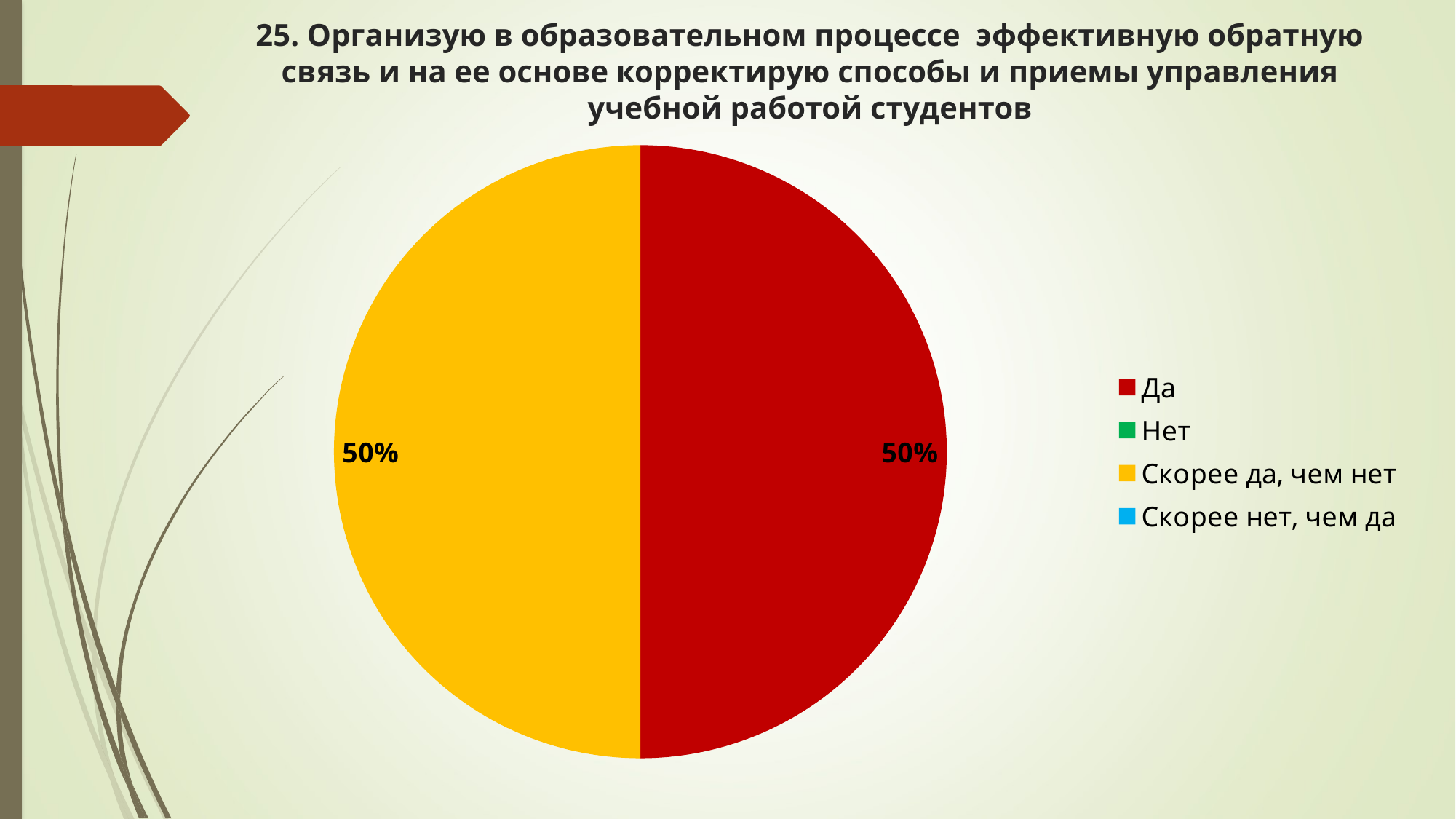
How many entries does the legend list? 4 Which legend entry is shown in yellow? Скорее да, чем нет What value is labelled on the yellow slice of the pie? 50% What value is labelled on the red slice of the pie? 50% What share of the pie does the "Да" slice represent? 50% What share of the pie does the "Скорее да, чем нет" slice represent? 50% Which colour represents "Да" in the legend? red How many slices are visible in the pie chart? 2 What is the difference between the "Да" share and the "Скорее да, чем нет" share? 0% What kind of chart is shown on the slide? pie chart